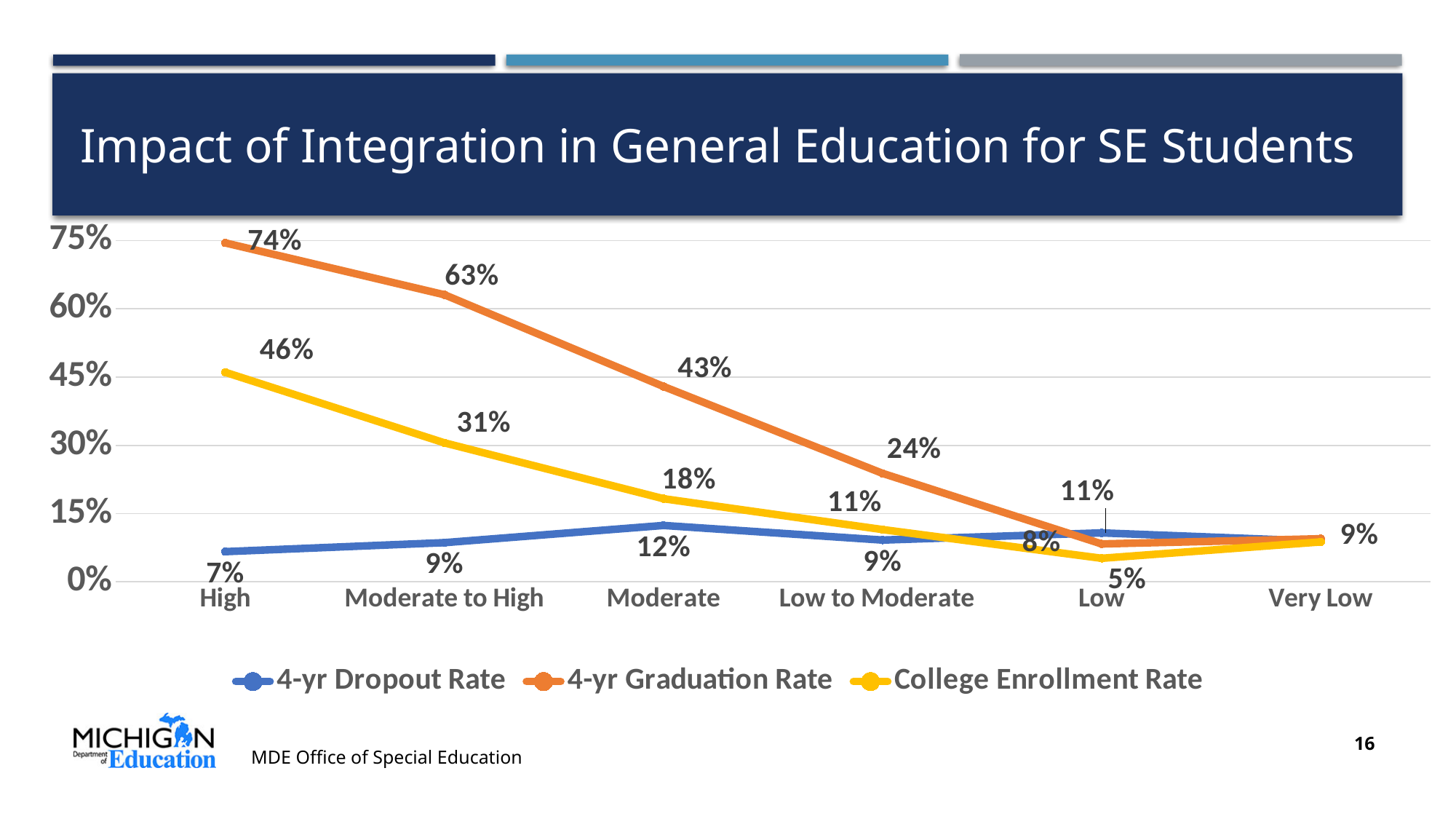
How many integration levels are shown on the x axis? 6 Does the 4-yr Graduation Rate rise or fall from High to Low integration? Fall At which integration level is the 4-yr Graduation Rate highest? High How many series does the legend list? 3 At the Moderate integration level, which is larger: the 4-yr Graduation Rate or the College Enrollment Rate? 4-yr Graduation Rate What is the 4-yr Graduation Rate for the High integration level? 74% What kind of chart is shown on the slide? Line chart By how many percentage points does the 4-yr Graduation Rate drop from High to Moderate to High? 11 percentage points What is the 4-yr Graduation Rate for the Low to Moderate integration level? 24% What is the College Enrollment Rate for the Moderate to High integration level? 31% At which integration level is the College Enrollment Rate lowest? Low What is the 4-yr Dropout Rate for the Moderate integration level? 12%